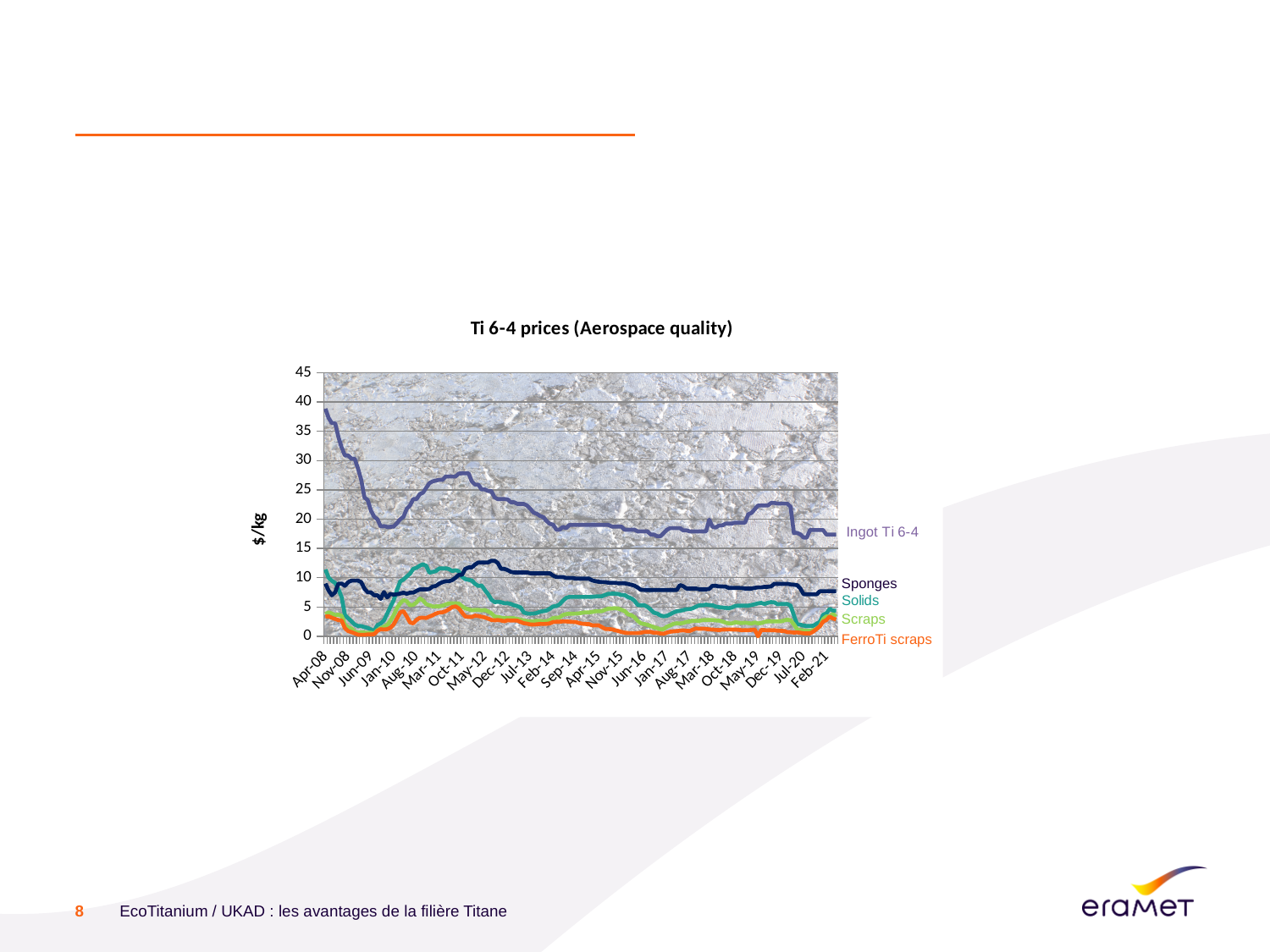
What kind of chart is shown on the slide? line chart What is the label on the y axis of the chart? $/kg At Feb-21, which series is higher, Sponges or Solids? Sponges How many series are labelled on the chart? 5 Is the Sponges value at Feb-21 greater or less than 10? less Which series has the lowest value at Feb-21? FerroTi scraps Is the Ingot Ti 6-4 value at Jun-09 greater or less than 25? less Is the Ingot Ti 6-4 value at Apr-08 greater or less than 35? greater What is the title of the chart? Ti 6-4 prices (Aerospace quality) Which series has the highest values across the whole chart? Ingot Ti 6-4 Does the Ingot Ti 6-4 line rise or fall from Apr-08 to Jun-09? fall